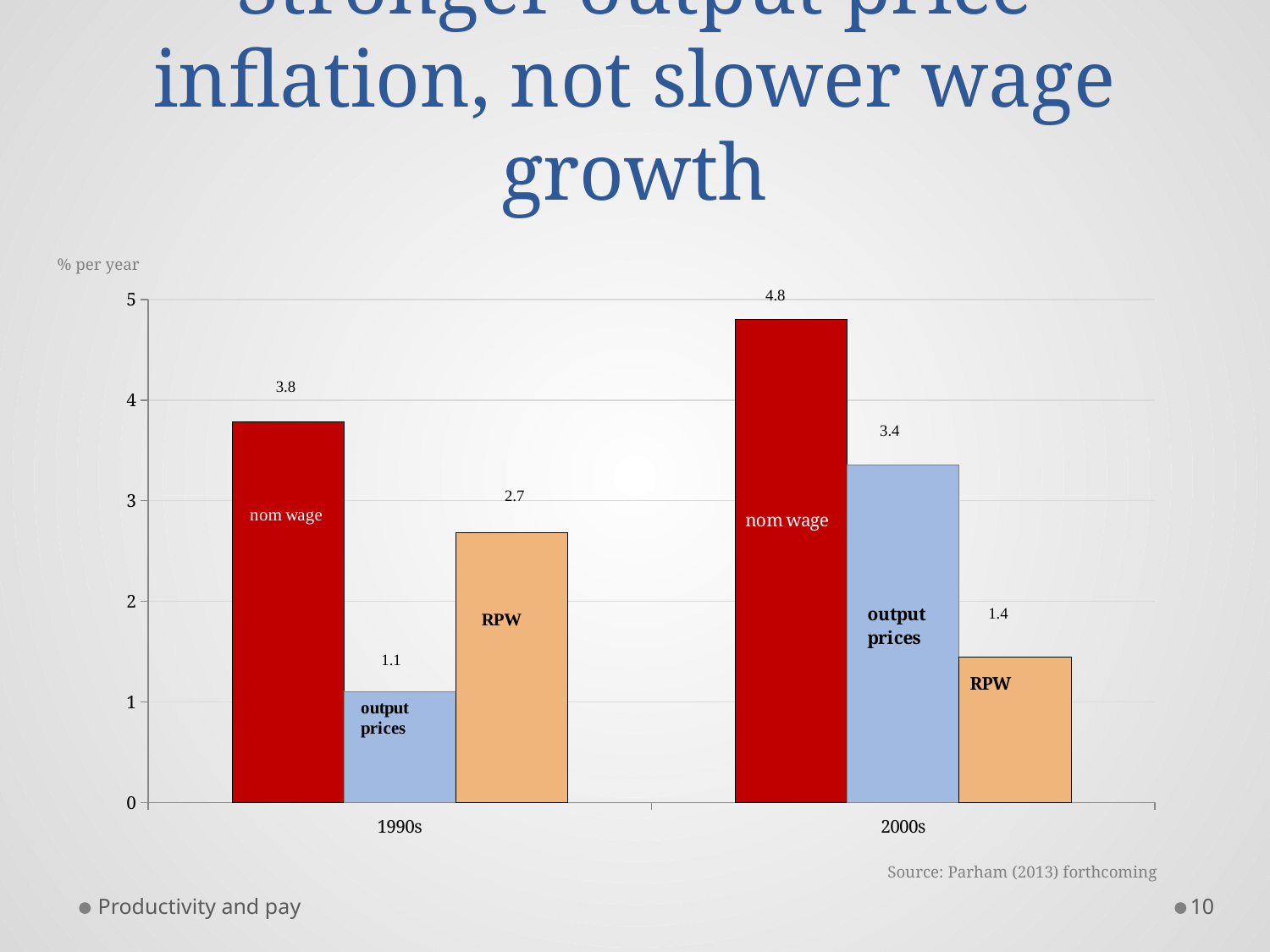
How many period categories are shown on the x axis? 2 What is the difference between output prices in the 2000s and output prices in the 1990s? 2.3 What kind of chart is shown on the slide? bar chart Is the value for nom wage in the 2000s greater or less than 4? greater Which series has the highest value in the 2000s? nom wage What unit is given for the vertical axis of the chart? % per year What is the value for nom wage in the 1990s? 3.8 What is the value for output prices in the 2000s? 3.4 What is the value for RPW in the 1990s? 2.7 Which is larger: RPW in the 1990s or RPW in the 2000s? RPW in the 1990s Which series has the lowest value in the 1990s? output prices What is the difference between nom wage in the 2000s and nom wage in the 1990s? 1.0